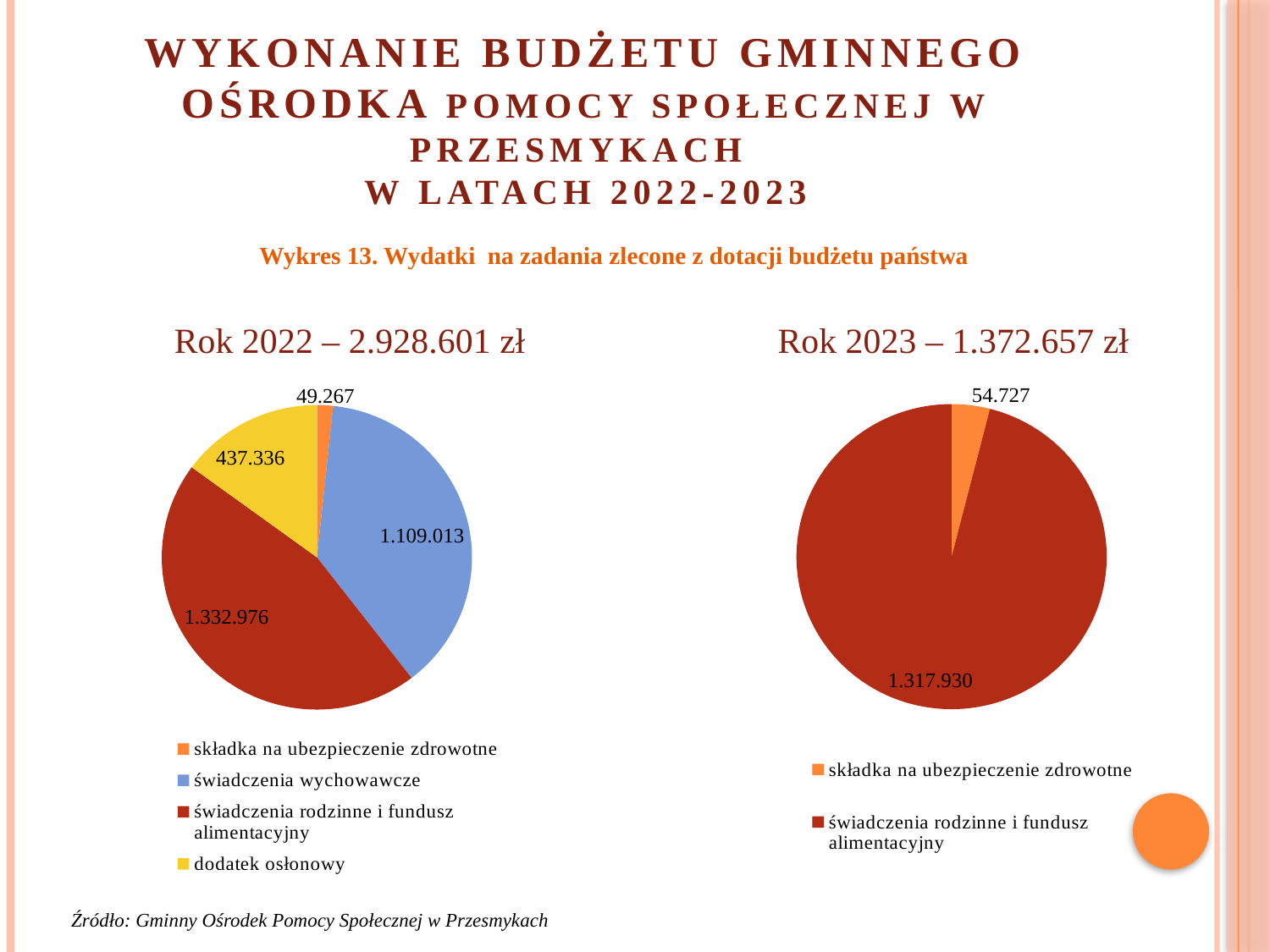
In the Rok 2022 chart, what is the difference between świadczenia rodzinne i fundusz alimentacyjny and świadczenia wychowawcze? 223.963 How many entries does the legend of the Rok 2023 chart list? 2 In the Rok 2022 chart, which category has the largest slice? świadczenia rodzinne i fundusz alimentacyjny In the Rok 2023 chart, which is larger: składka na ubezpieczenie zdrowotne or świadczenia rodzinne i fundusz alimentacyjny? świadczenia rodzinne i fundusz alimentacyjny In the Rok 2022 chart, what is the value for dodatek osłonowy? 437.336 What type of charts are shown on the slide? Pie charts In the Rok 2023 chart, what is the total of the two slices? 1.372.657 How many slices does the Rok 2022 pie chart have? 4 In the Rok 2023 chart, what is the value for składka na ubezpieczenie zdrowotne? 54.727 In the Rok 2022 chart, what is the value for świadczenia wychowawcze? 1.109.013 In the Rok 2022 chart, which category has the smallest slice? składka na ubezpieczenie zdrowotne In the Rok 2022 chart, what colour is the slice for dodatek osłonowy? Yellow